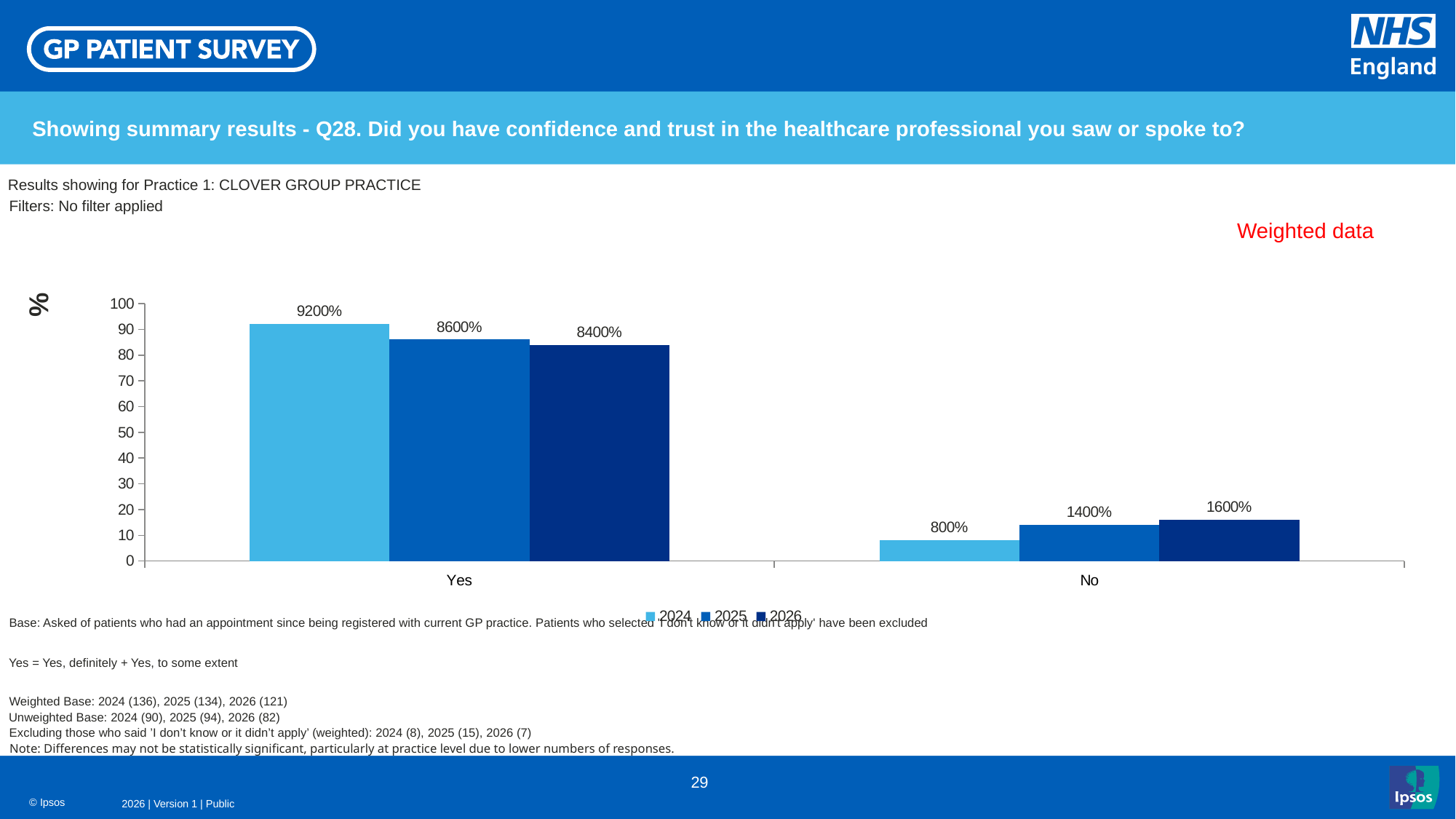
What is the data label shown for the 2026 bar in the No category? 1600% How many series does the legend list? 3 What kind of chart is shown on the slide? bar chart What is the data label shown for the 2025 bar in the Yes category? 8600% How many categories are shown on the x axis? 2 What is the data label shown for the 2024 bar in the No category? 800% Which year has the lowest bar in the No category? 2024 Which year has the highest bar in the Yes category? 2024 Is the 2025 bar in the Yes category larger or smaller than the 2026 bar in the Yes category? larger Do the bars in the Yes category rise or fall from 2024 to 2026? fall Is the 2026 bar in the No category greater or less than 10 on the axis? greater What is the data label shown for the 2024 bar in the Yes category? 9200%